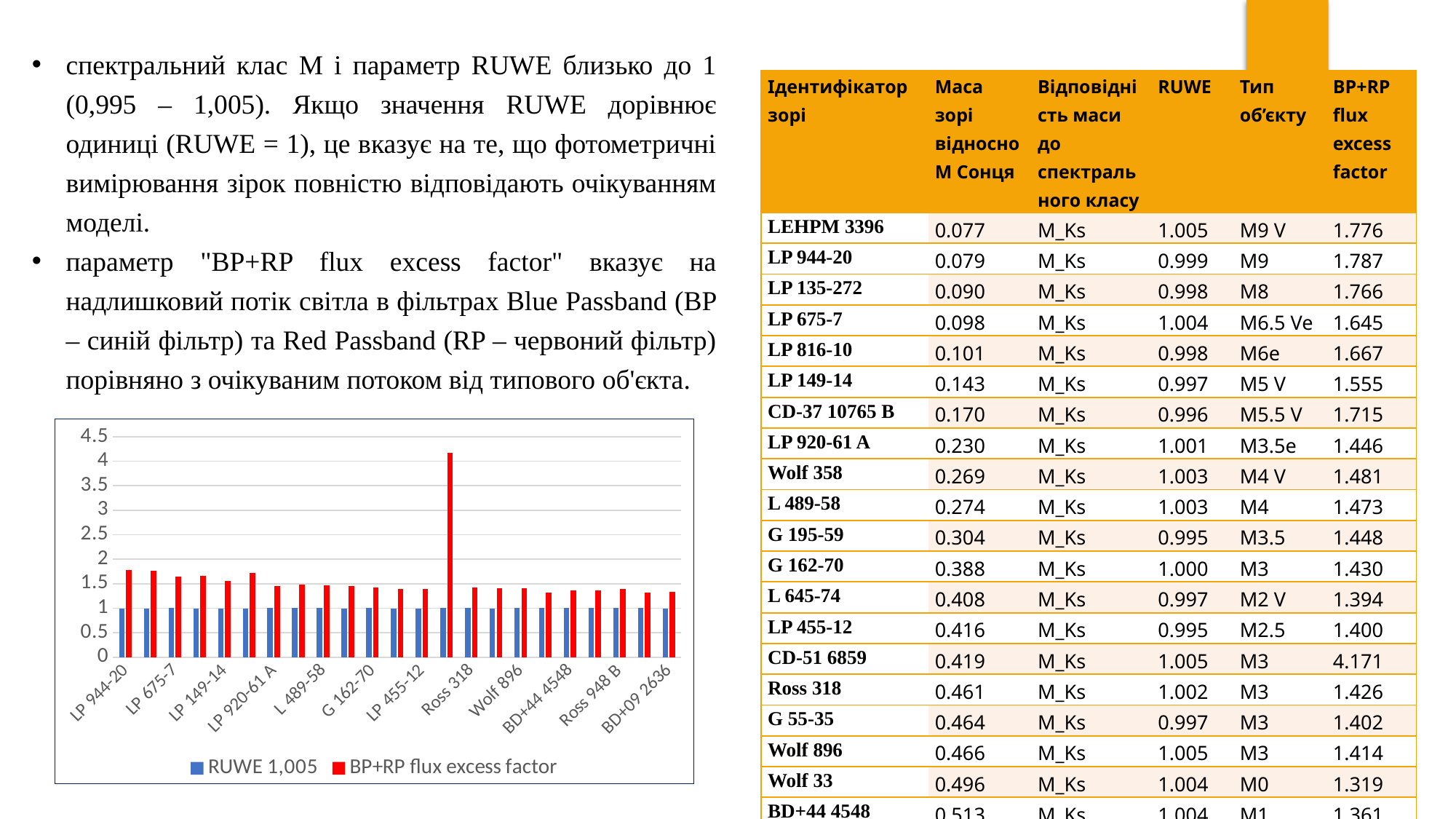
Is the BP+RP flux excess factor value for LP 944-20 greater or less than 1.5? greater Is the BP+RP flux excess factor value for Wolf 896 greater or less than 1.5? less Is the BP+RP flux excess factor value for BD+09 2636 greater or less than 2? less Which colour represents the BP+RP flux excess factor series in the chart? red Which has the larger BP+RP flux excess factor bar: LP 944-20 or Ross 318? LP 944-20 What kind of chart is shown on the slide? bar chart For LP 944-20, which is larger: the RUWE 1,005 bar or the BP+RP flux excess factor bar? BP+RP flux excess factor What are the two series named in the chart legend? RUWE 1,005 and BP+RP flux excess factor How many series does the chart legend list? 2